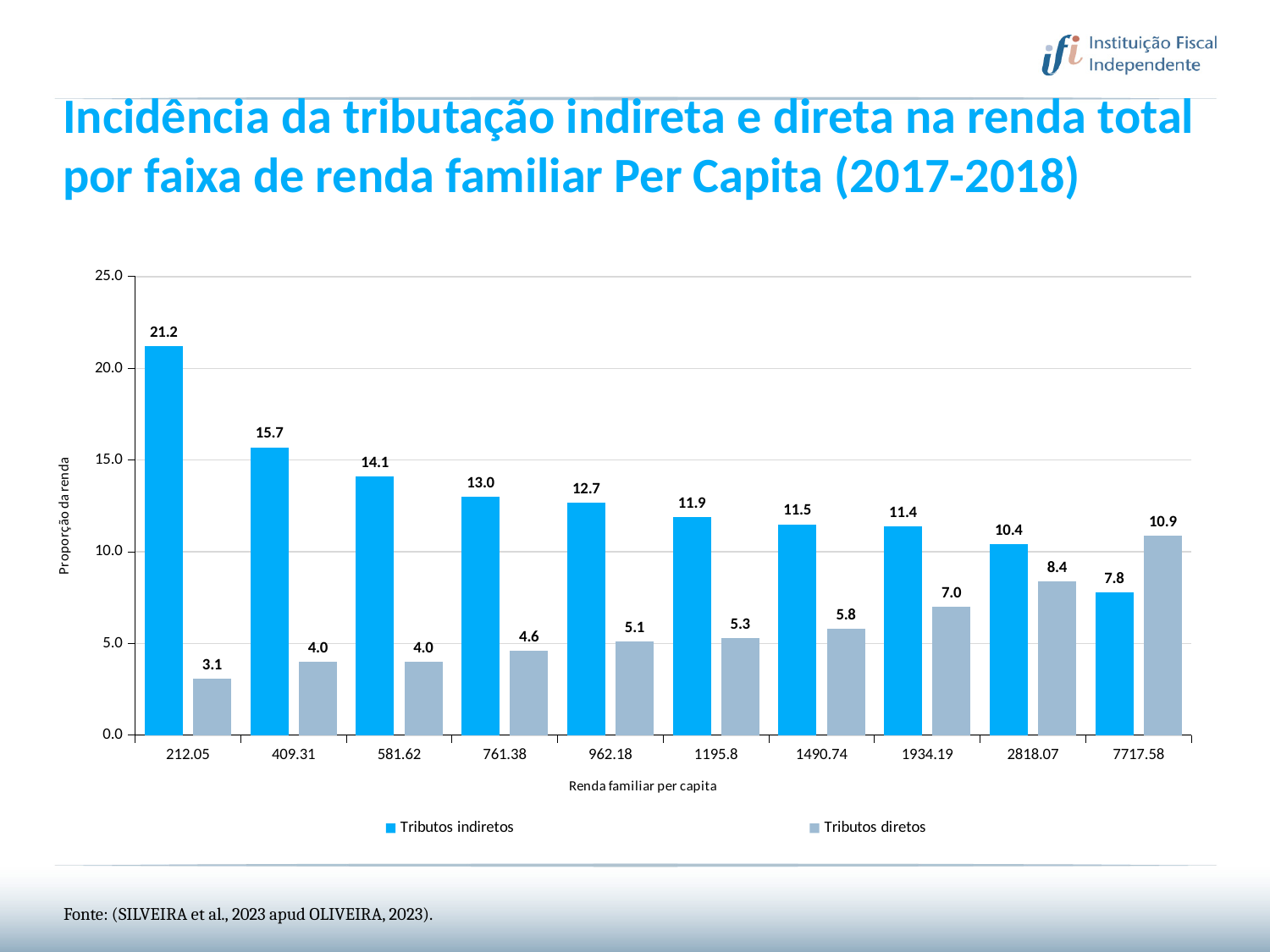
What is the value of Tributos indiretos for the income bracket 212.05? 21.2 How many income brackets are shown on the x axis? 10 How many series does the legend list? 2 For the income bracket 7717.58, which is larger: Tributos indiretos or Tributos diretos? Tributos diretos Do the values for Tributos diretos rise or fall as income brackets increase along the x axis? Rise Which income bracket has the highest value for Tributos indiretos? 212.05 Is the value of Tributos indiretos for the income bracket 409.31 greater or less than 15.0? greater What is the difference between Tributos indiretos and Tributos diretos for the income bracket 212.05? 18.1 What is the value of Tributos diretos for the income bracket 1490.74? 5.8 What kind of chart is shown on the slide? Bar chart What is the value of Tributos diretos for the income bracket 7717.58? 10.9 Which income bracket has the lowest value for Tributos diretos? 212.05